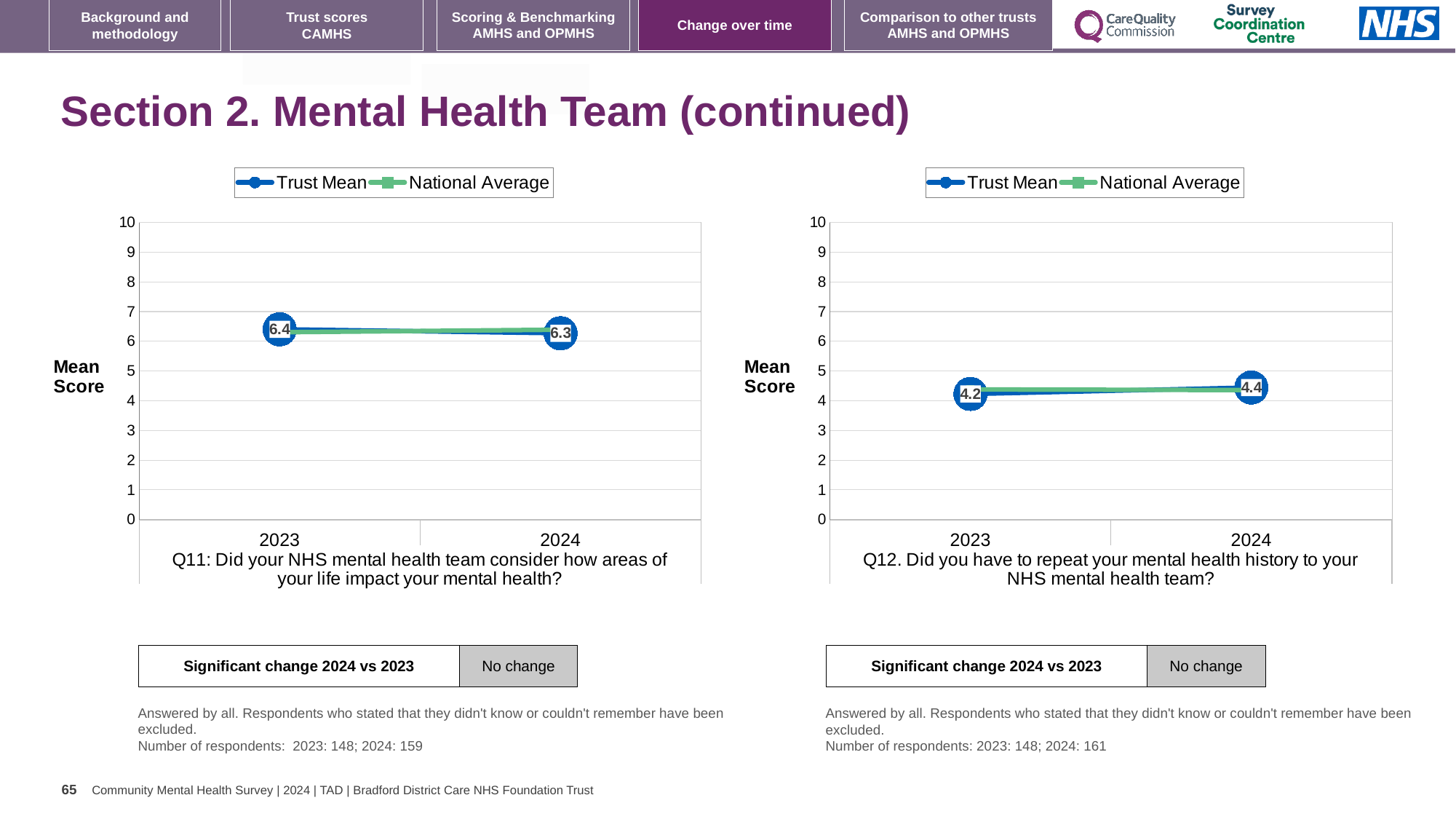
In the Q11 chart (left), what is the Trust Mean for 2024? 6.3 In the Q11 chart (left), which year has the higher Trust Mean, 2023 or 2024? 2023 How many series does the legend of the Q11 chart (left) list? 2 How many years are plotted on the x axis of the Q11 chart (left)? 2 In the Q12 chart (right), by how much did the Trust Mean change from 2023 to 2024? 0.2 What type of chart is the Q12 chart (right)? line chart In the Q12 chart (right), does the Trust Mean rise or fall from 2023 to 2024? rise In the Q11 chart (left), is the Trust Mean for 2024 greater or less than 5? greater In the Q11 chart (left), what is the Trust Mean for 2023? 6.4 In the Q12 chart (right), what is the Trust Mean for 2023? 4.2 In the Q12 chart (right), is the Trust Mean for 2023 greater or less than 5? less In the Q12 chart (right), what is the Trust Mean for 2024? 4.4